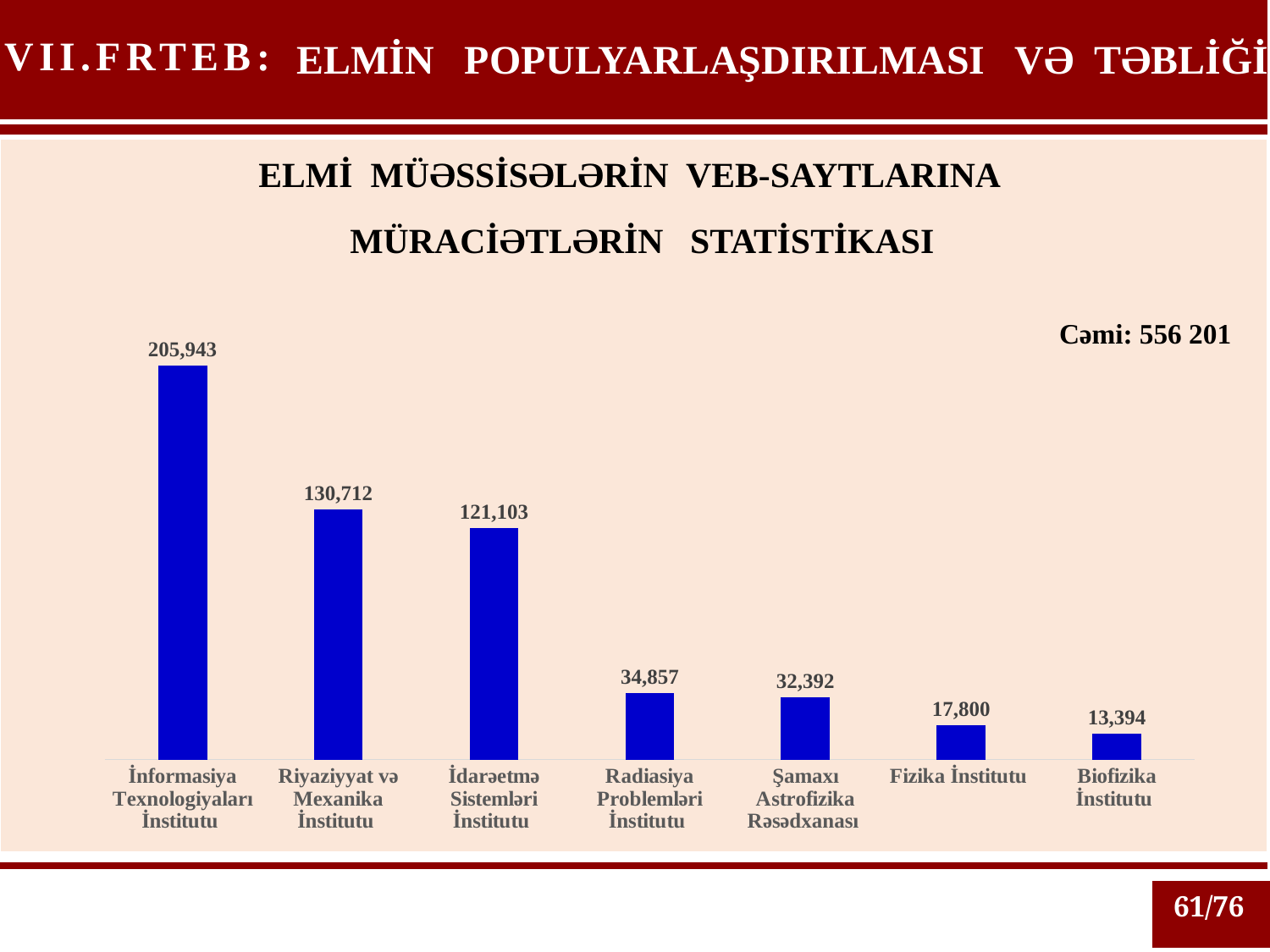
What is the difference between the values for İnformasiya Texnologiyaları İnstitutu and Riyaziyyat və Mexanika İnstitutu? 75,231 Do the values rise or fall from left to right across the chart? Fall What is the value for Şamaxı Astrofizika Rəsədxanası? 32,392 Which institution has the lowest value? Biofizika İnstitutu What is the value for İnformasiya Texnologiyaları İnstitutu? 205,943 What kind of chart is shown on the slide? Bar chart What is the value for Fizika İnstitutu? 17,800 What is the difference between the values for Fizika İnstitutu and Biofizika İnstitutu? 4,406 Which institution has the highest value? İnformasiya Texnologiyaları İnstitutu How many institutions are shown in the chart? 7 Which is larger, the value for Riyaziyyat və Mexanika İnstitutu or İdarəetmə Sistemləri İnstitutu? Riyaziyyat və Mexanika İnstitutu What total (Cəmi) is stated on the slide? 556 201